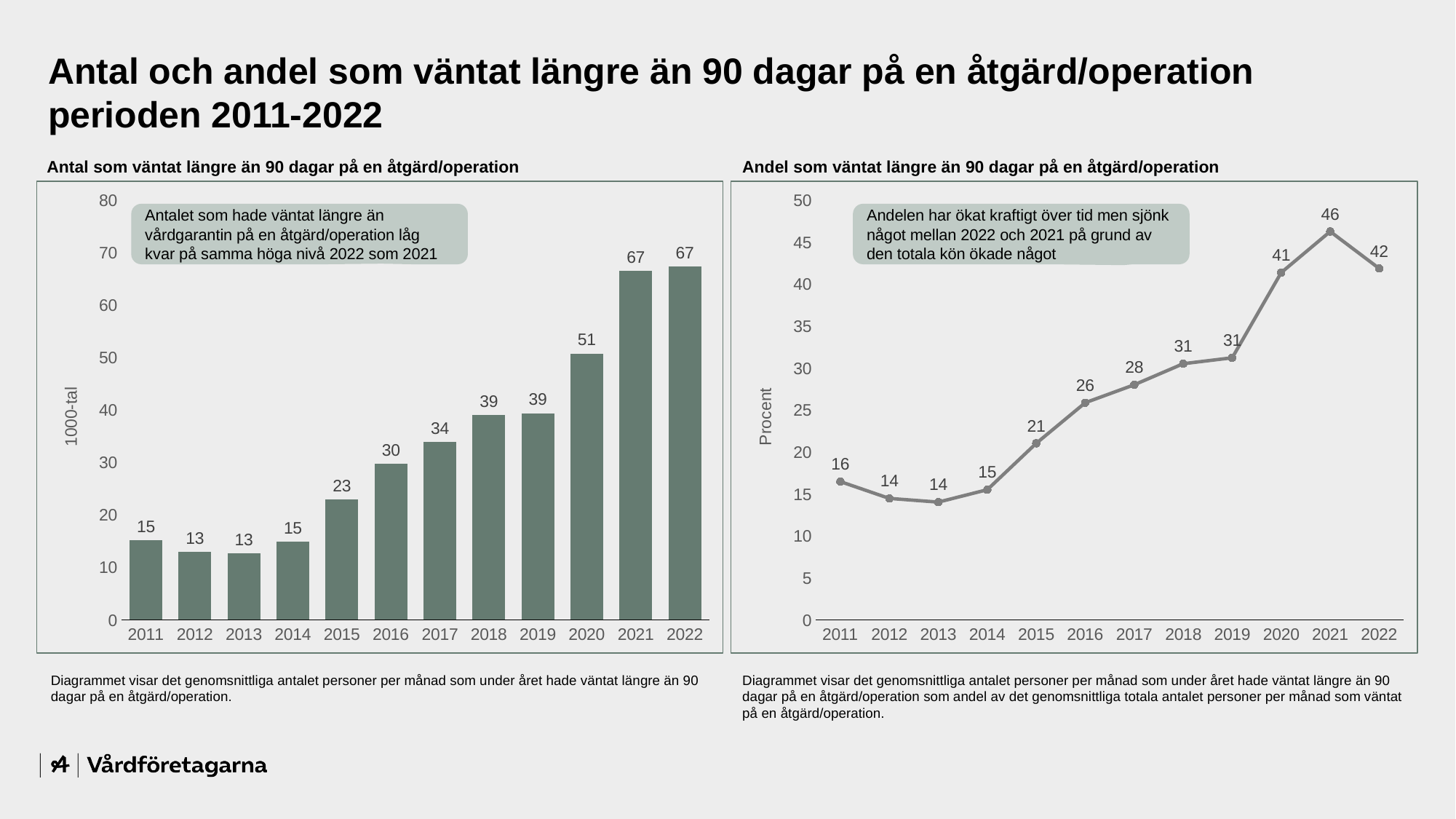
What kind of chart is the left chart 'Antal som väntat längre än 90 dagar på en åtgärd/operation'? Bar chart What kind of chart is the right chart 'Andel som väntat längre än 90 dagar på en åtgärd/operation'? Line chart In the right chart 'Andel som väntat längre än 90 dagar på en åtgärd/operation', what is the value for 2017? 28 In the left chart 'Antal som väntat längre än 90 dagar på en åtgärd/operation', what is the difference between the values for 2021 and 2015? 44 In the right chart 'Andel som väntat längre än 90 dagar på en åtgärd/operation', which year has the highest value? 2021 In the left chart 'Antal som väntat längre än 90 dagar på en åtgärd/operation', what is the value for 2020? 51 In the left chart 'Antal som väntat längre än 90 dagar på en åtgärd/operation', what is the y-axis label? 1000-tal In the left chart 'Antal som väntat längre än 90 dagar på en åtgärd/operation', how many years are shown on the x axis? 12 In the right chart 'Andel som väntat längre än 90 dagar på en åtgärd/operation', which is larger, the value for 2016 or the value for 2019? 2019 In the right chart 'Andel som väntat längre än 90 dagar på en åtgärd/operation', do the values generally rise or fall from 2013 to 2021? Rise In the left chart 'Antal som väntat längre än 90 dagar på en åtgärd/operation', which year has the lowest value? 2012 and 2013 In the right chart 'Andel som väntat längre än 90 dagar på en åtgärd/operation', what is the difference between the values for 2021 and 2022? 4